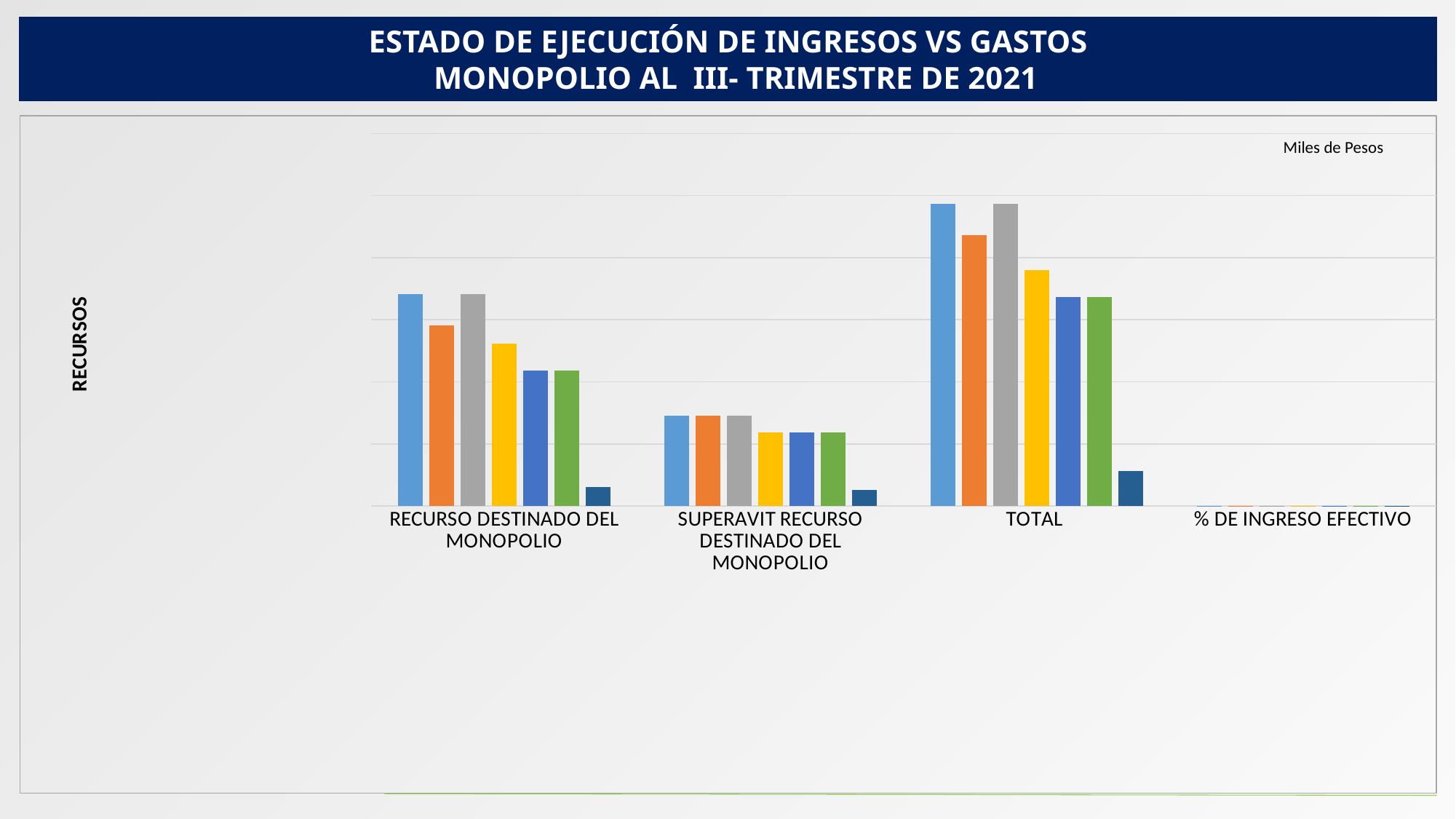
How many categories are shown along the x axis of the chart? 4 Within the TOTAL category, is the first (light blue) bar taller or shorter than the last (dark blue) bar? taller What unit is indicated in the top right corner of the chart area? Miles de Pesos Is the orange bar for RECURSO DESTINADO DEL MONOPOLIO taller or shorter than the orange bar for SUPERAVIT RECURSO DESTINADO DEL MONOPOLIO? taller How many bars are plotted for the TOTAL category? 7 What kind of chart is shown on the slide? bar chart Within the SUPERAVIT RECURSO DESTINADO DEL MONOPOLIO category, is the gray bar taller or shorter than the green bar? taller What is the title of the chart on the slide? ESTADO DE EJECUCIÓN DE INGRESOS VS GASTOS MONOPOLIO AL III- TRIMESTRE DE 2021 Which category on the x axis has the tallest bars? TOTAL Which category on the x axis has the shortest bars? % DE INGRESO EFECTIVO